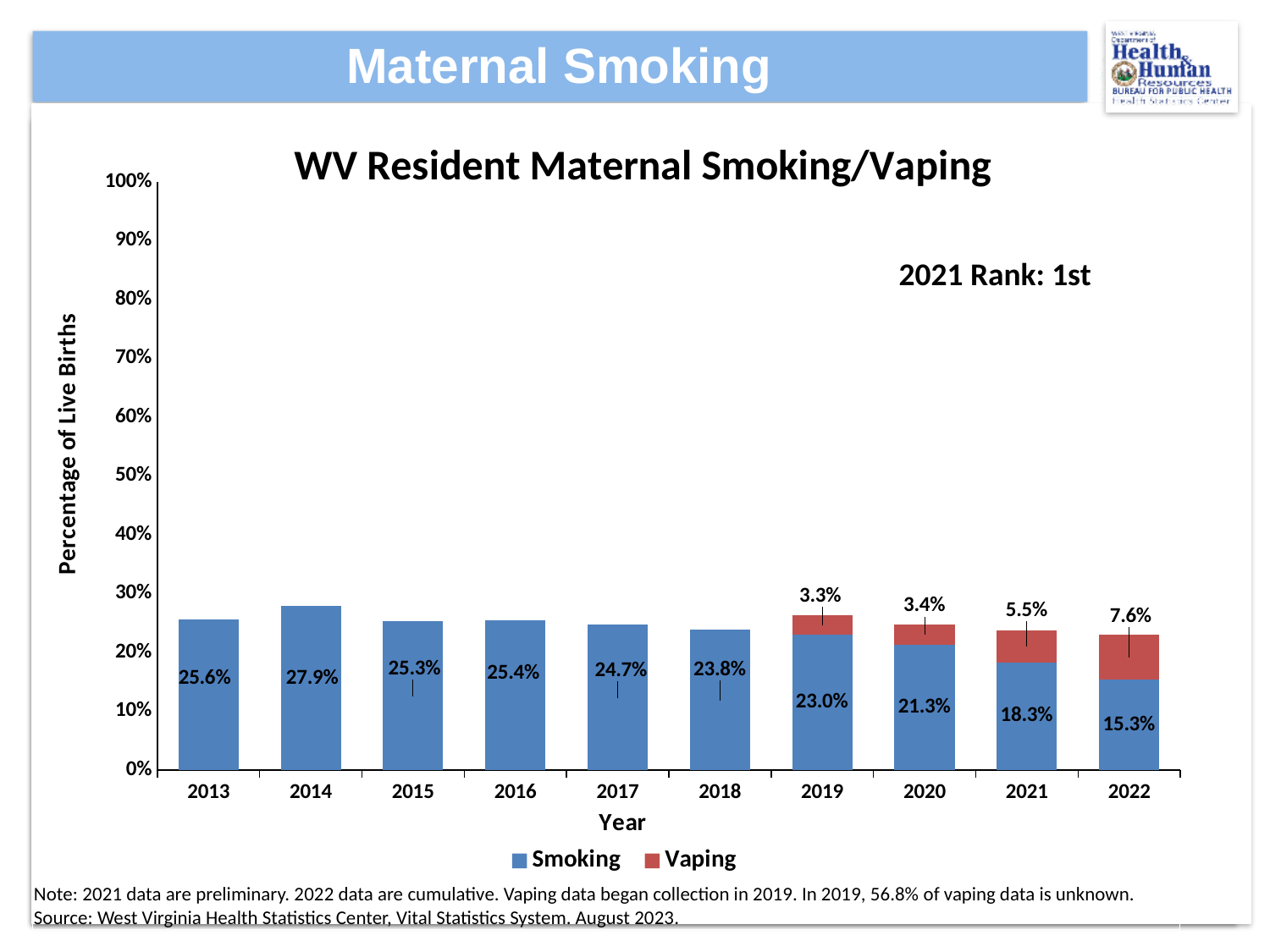
Is the Smoking value for 2018 greater or less than 20%? greater What is the Smoking value for 2020? 21.3% How many series does the legend list? 2 What is the Vaping value for 2022? 7.6% What kind of chart is shown? Stacked bar chart What is the Smoking value for 2014? 27.9% Which year has the lowest Smoking value? 2022 What is the difference between the Smoking values for 2013 and 2022? 10.3% What is the total of the stacked bar for 2022 (Smoking plus Vaping)? 22.9% Which year has the highest Smoking value? 2014 How many years are shown on the x axis? 10 Which is larger, the Vaping value for 2021 or the Vaping value for 2019? 2021